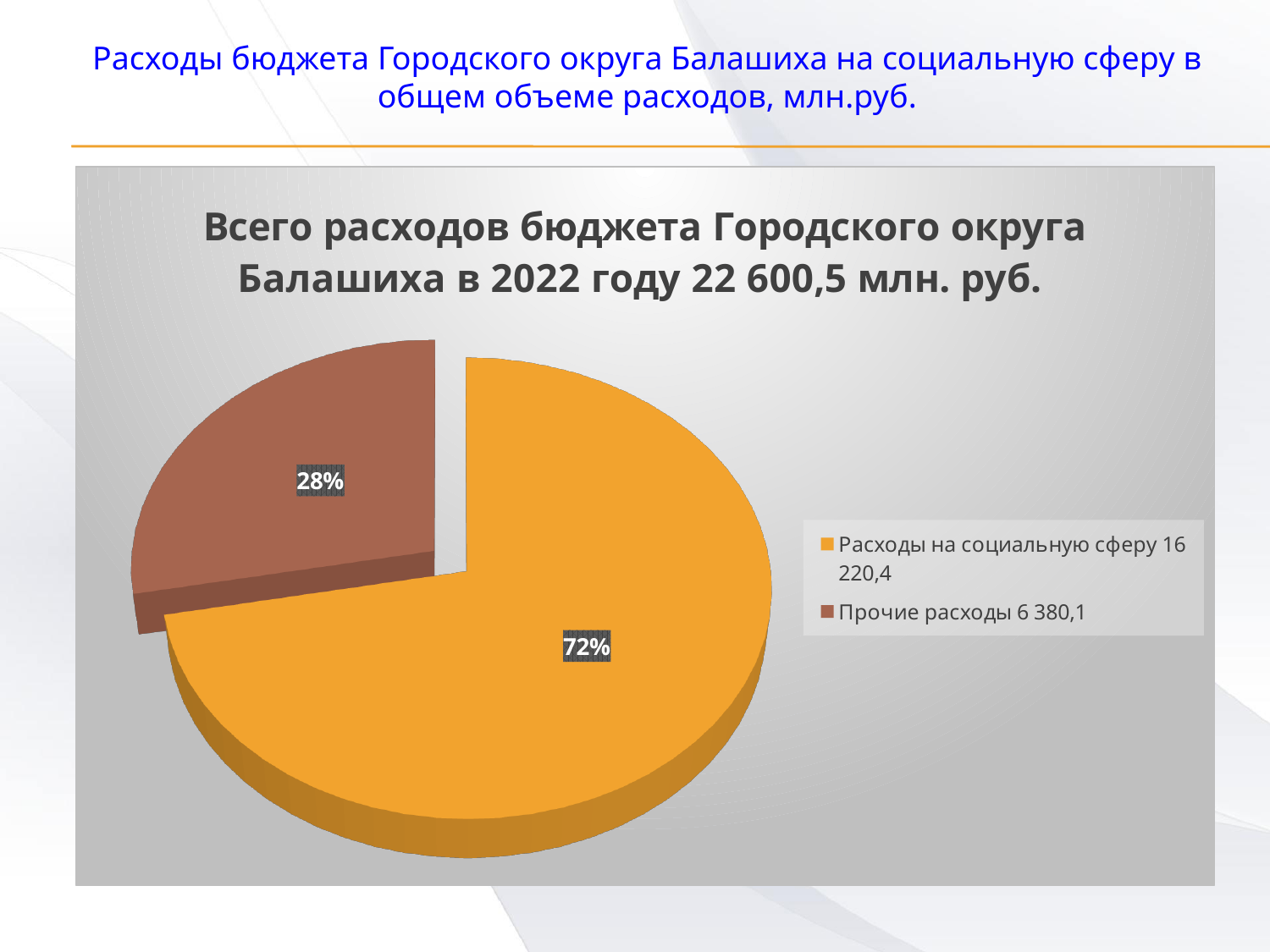
What is the difference in percentage points between the 72% slice and the 28% slice? 44 percentage points What kind of chart is shown on the slide? Pie chart Which slice of the pie is the largest? Расходы на социальную сферу Which slice of the pie is the smallest? Прочие расходы What value is given in the legend for "Прочие расходы"? 6 380,1 How many slices does the pie chart have? 2 According to the chart title, what was the total budget expenditure of Городской округ Балашиха in 2022? 22 600,5 млн. руб. What share of the pie is labelled for "Прочие расходы"? 28% What share of the pie is labelled for "Расходы на социальную сферу"? 72% Which is larger: the share for "Расходы на социальную сферу" or for "Прочие расходы"? Расходы на социальную сферу What value is given in the legend for "Расходы на социальную сферу"? 16 220,4 What colour is the slice for "Прочие расходы"? Brown